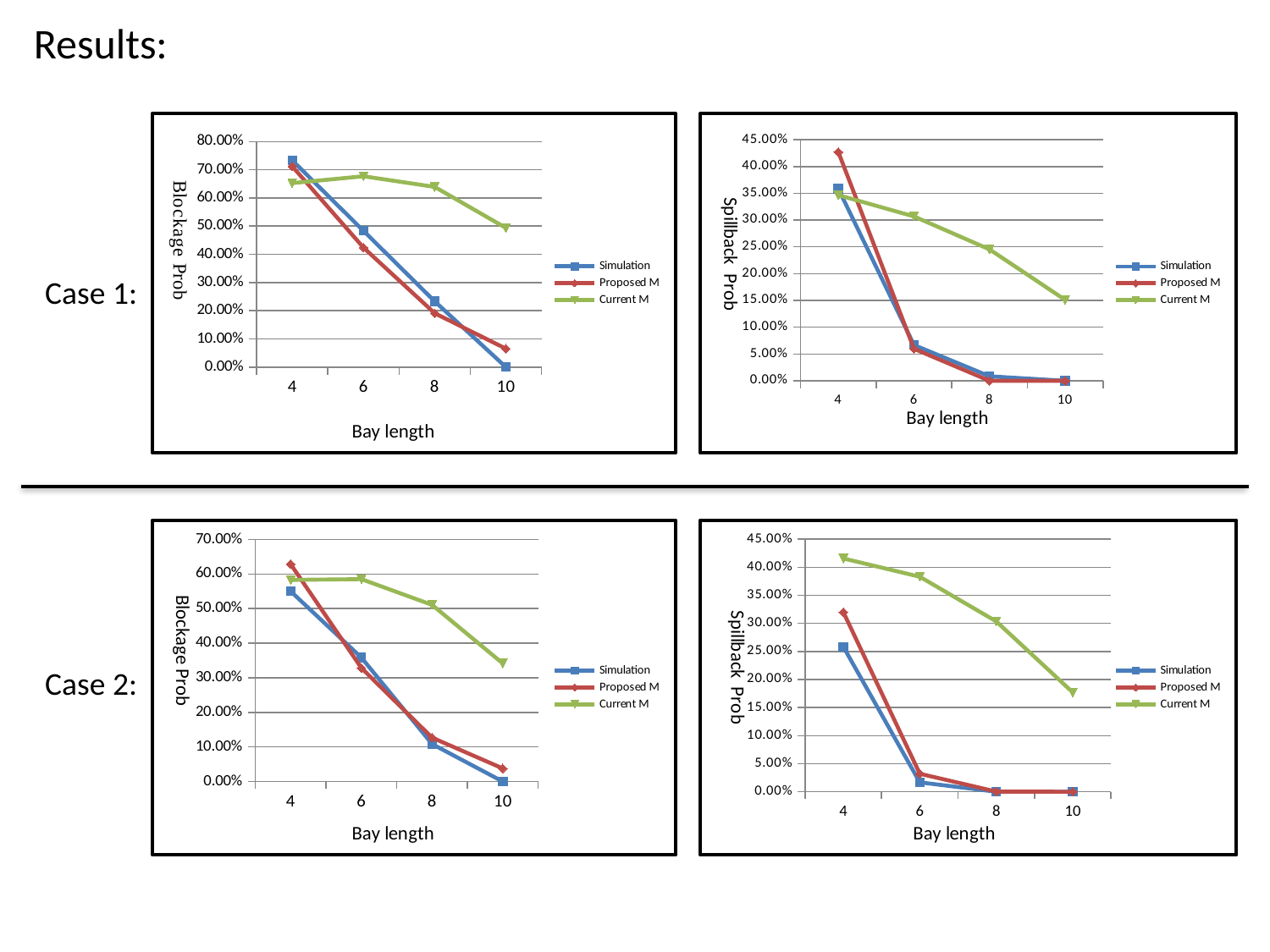
In the Case 1 Blockage Prob chart (top-left), which series has the lowest value at bay length 10? Simulation In the Case 1 Spillback Prob chart (top-right), which series has the highest value at bay length 4? Proposed M In the Case 1 Spillback Prob chart (top-right), is the Proposed M value at bay length 4 greater or less than 40.00%? greater In the Case 2 Spillback Prob chart (bottom-right), is the Proposed M value at bay length 4 greater or less than 30.00%? greater In the Case 2 Blockage Prob chart (bottom-left), is the Current M value at bay length 10 greater or less than 40.00%? less In the Case 2 Spillback Prob chart (bottom-right), which is larger at bay length 4: Current M or Simulation? Current M How many bay length values are plotted on the x axis of the Case 1 Spillback Prob chart (top-right)? 4 What is the x-axis label of the Case 2 Blockage Prob chart (bottom-left)? Bay length How many series does the legend of the Case 2 Spillback Prob chart (bottom-right) list? 3 In the Case 2 Blockage Prob chart (bottom-left), does the Simulation series rise or fall as bay length increases from 4 to 10? fall What kind of chart is the Case 1 Blockage Prob chart (top-left)? line chart